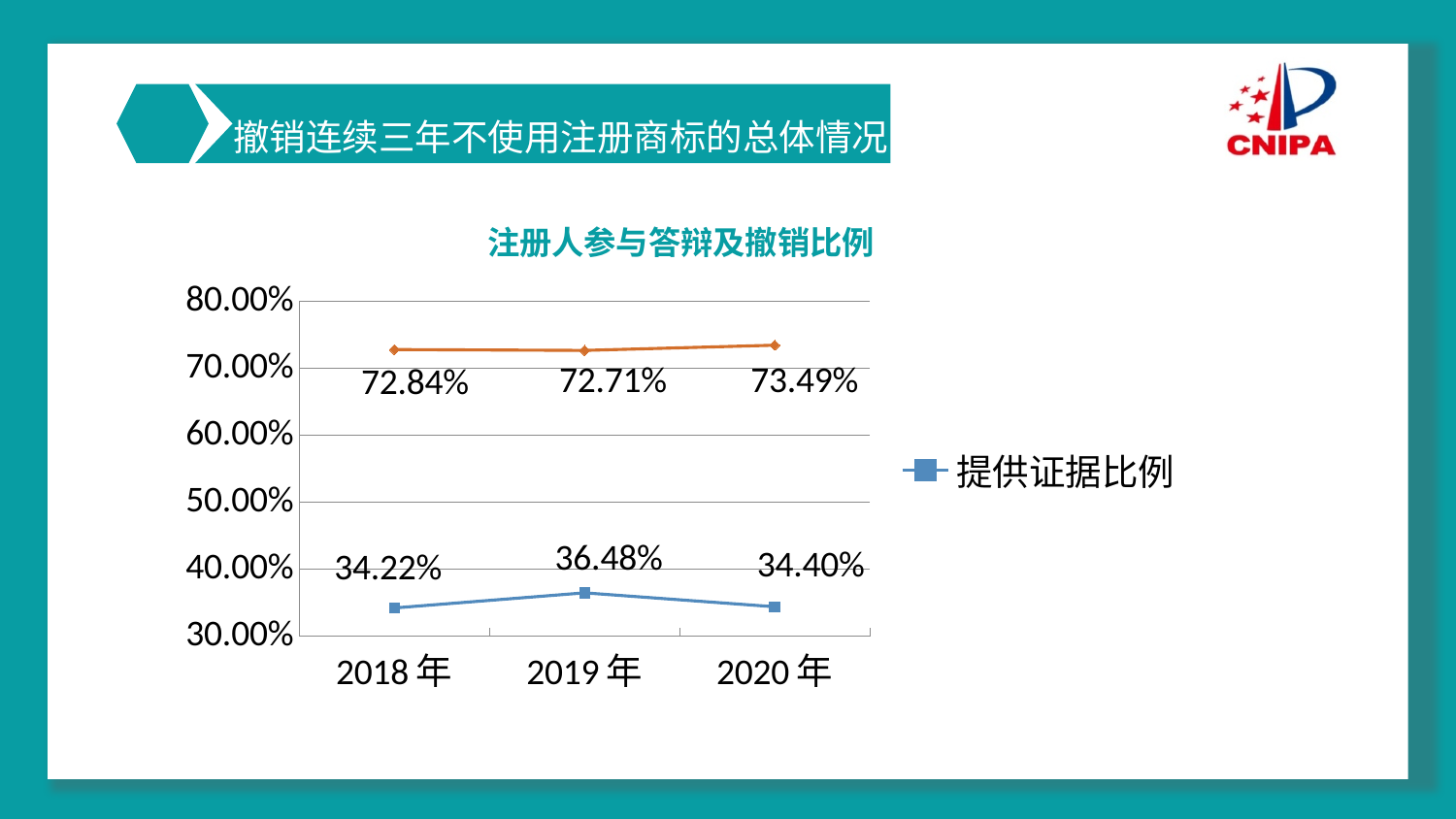
What is the value of the orange (upper) line for 2020年? 73.49% In which year is the orange (upper) line lowest? 2019年 In which year is 提供证据比例 highest? 2019年 What type of chart is shown on the slide? line chart How many series does the legend list? 1 What is the difference between the 提供证据比例 values for 2019年 and 2018年? 2.26% What is the value of 提供证据比例 for 2018年? 34.22% What is the value of the orange (upper) line for 2019年? 72.71% How many years are shown on the x axis? 3 Is the value of 提供证据比例 for 2020年 greater or less than 40.00%? less What is the title of the chart? 注册人参与答辩及撤销比例 What is the value of 提供证据比例 for 2019年? 36.48%